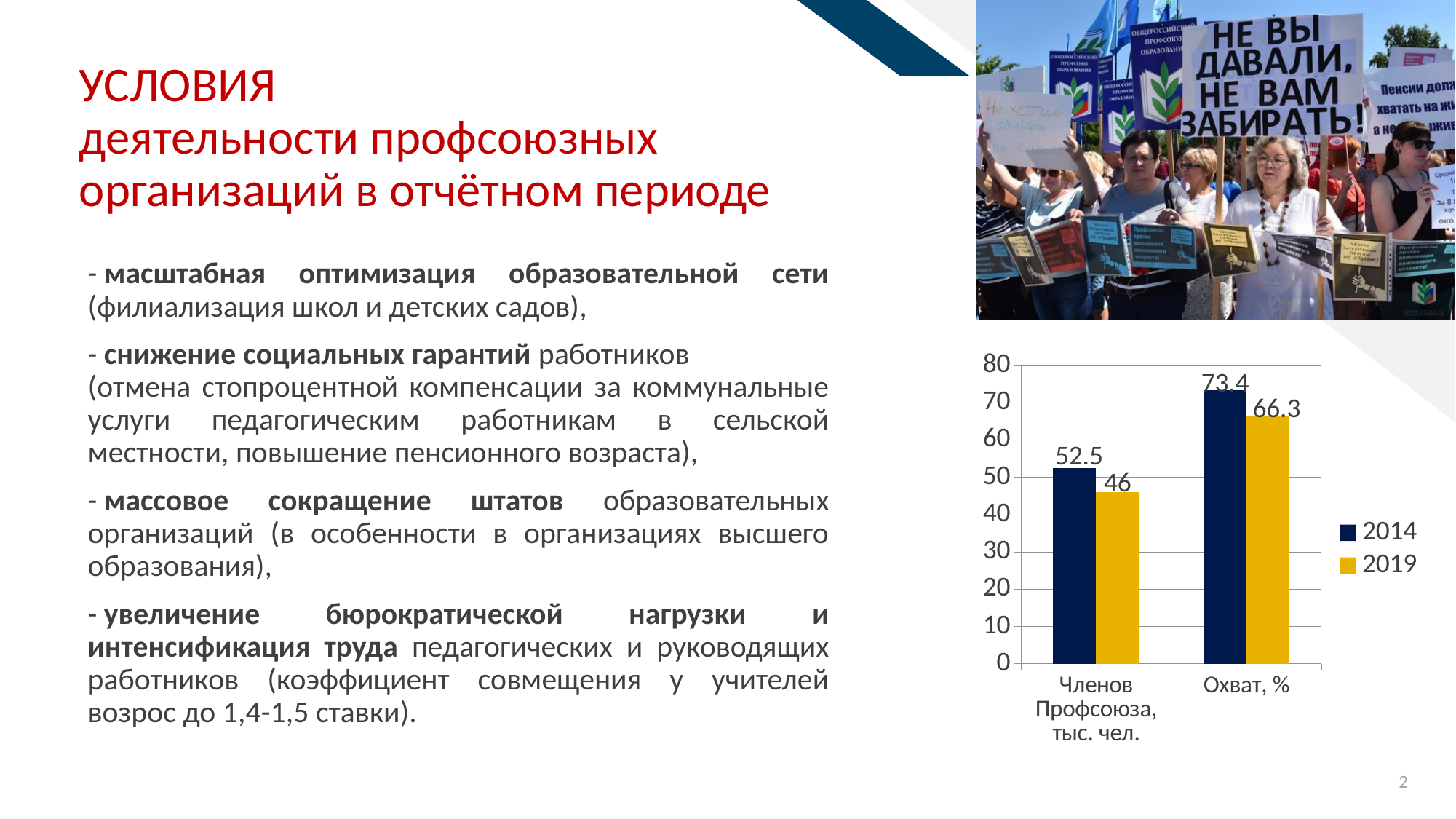
What kind of chart is shown on the slide? Bar chart How many categories are shown on the x axis of the chart? 2 What is the difference between the 2014 and 2019 values in the category "Членов Профсоюза, тыс. чел."? 6.5 Which bar in the chart has the highest value? 2014, Охват, % What is the value for 2019 in the category "Членов Профсоюза, тыс. чел."? 46 How many series does the chart legend list? 2 What is the difference between the 2014 and 2019 values in the category "Охват, %"? 7.1 What is the value for 2014 in the category "Членов Профсоюза, тыс. чел."? 52.5 Which series has the higher value in the category "Охват, %", 2014 or 2019? 2014 Which bar in the chart has the lowest value? 2019, Членов Профсоюза, тыс. чел. What is the value for 2014 in the category "Охват, %"? 73.4 What is the value for 2019 in the category "Охват, %"? 66.3